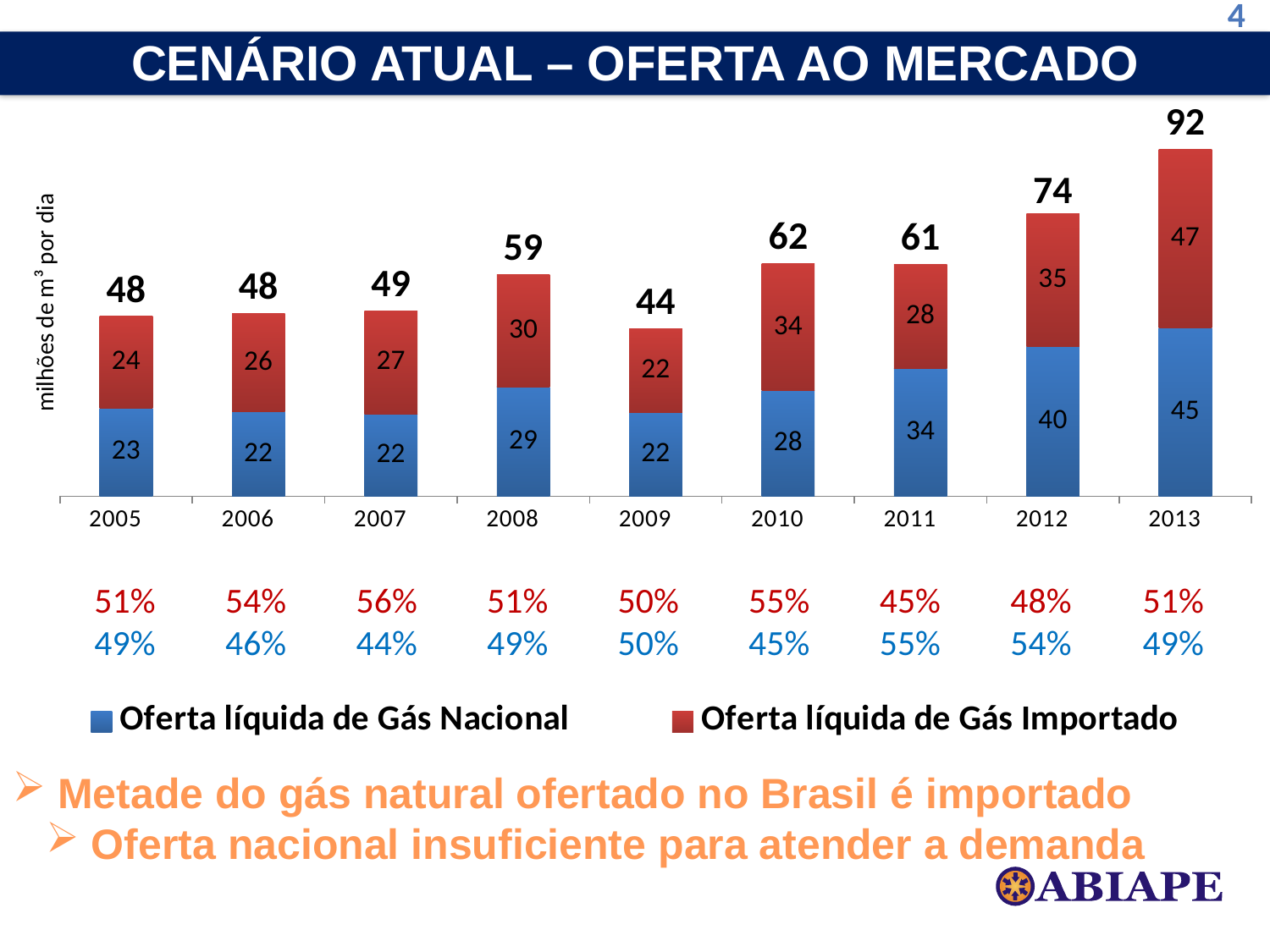
What is the difference between Oferta líquida de Gás Importado and Oferta líquida de Gás Nacional in 2010? 6 What is the value of Oferta líquida de Gás Importado for 2013? 47 What is the total of the stacked bar for 2012? 74 What kind of chart is shown on the slide? Stacked bar chart Do the total values generally rise or fall from 2009 to 2013? Rise Which year has the highest total stacked bar? 2013 What is the unit shown on the vertical axis label? milhões de m³ por dia Which year has the lowest total stacked bar? 2009 Which is larger in 2011, Oferta líquida de Gás Nacional or Oferta líquida de Gás Importado? Oferta líquida de Gás Nacional How many years are shown on the x axis? 9 What is the value of Oferta líquida de Gás Nacional for 2008? 29 How many series does the legend list? 2